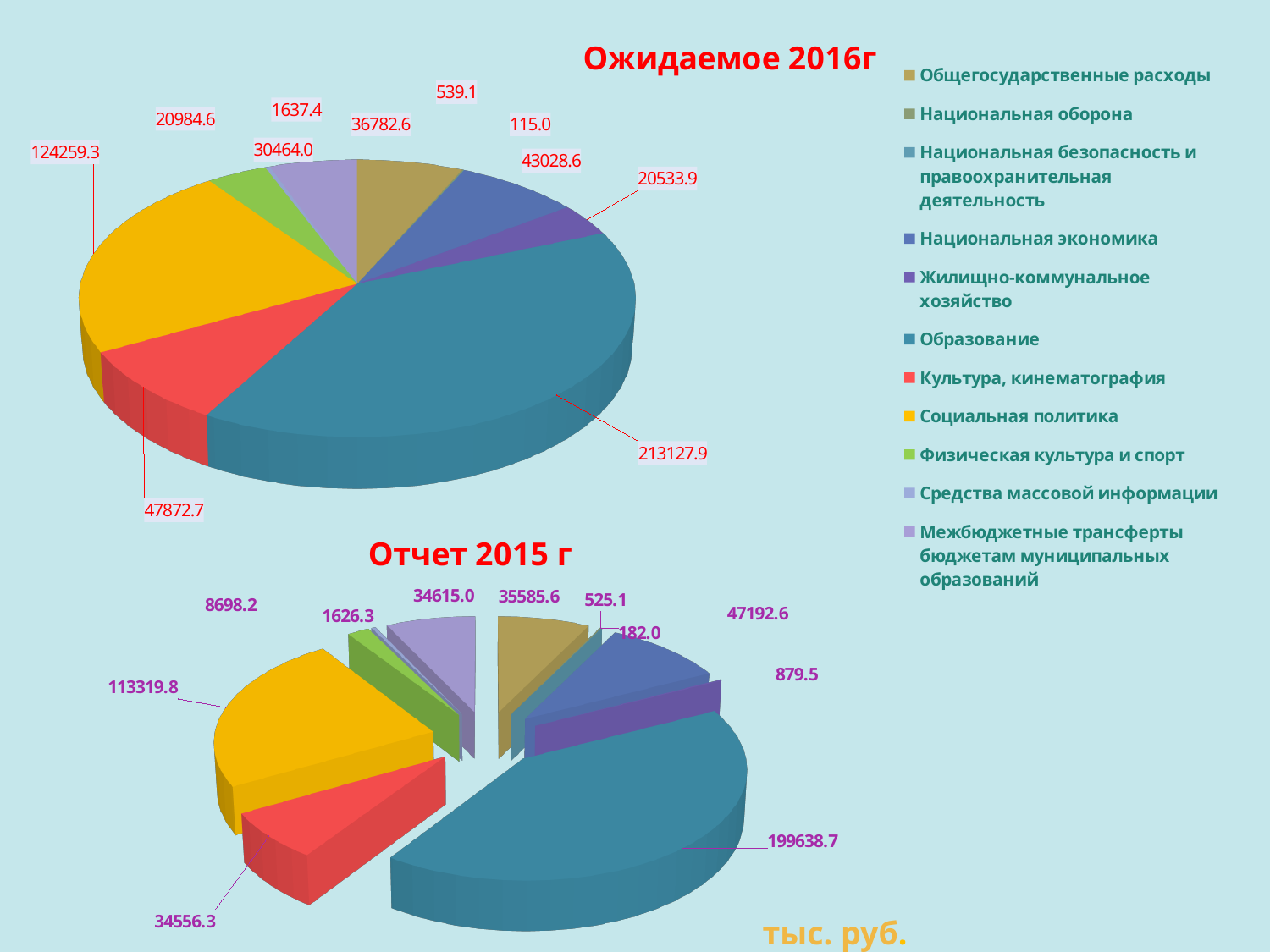
In the "Ожидаемое 2016г" chart, which category has the largest slice? Образование In the "Отчет 2015 г" chart, what is the value for Социальная политика? 113319.8 How many categories does the legend list? 11 How much larger is the value for Образование in the "Ожидаемое 2016г" chart than in the "Отчет 2015 г" chart? 13489.2 In the "Отчет 2015 г" chart, what is the value for Образование? 199638.7 What unit is indicated at the bottom right of the slide for the chart values? тыс. руб. In the "Ожидаемое 2016г" chart, which is larger: Культура, кинематография or Общегосударственные расходы? Культура, кинематография In the "Отчет 2015 г" chart, which category has the largest slice? Образование In the "Отчет 2015 г" chart, what is the value for Культура, кинематография? 34556.3 In the "Ожидаемое 2016г" chart, what is the value for Социальная политика? 124259.3 In the "Ожидаемое 2016г" chart, what is the value for Образование? 213127.9 What kind of chart is the "Ожидаемое 2016г" chart? Pie chart